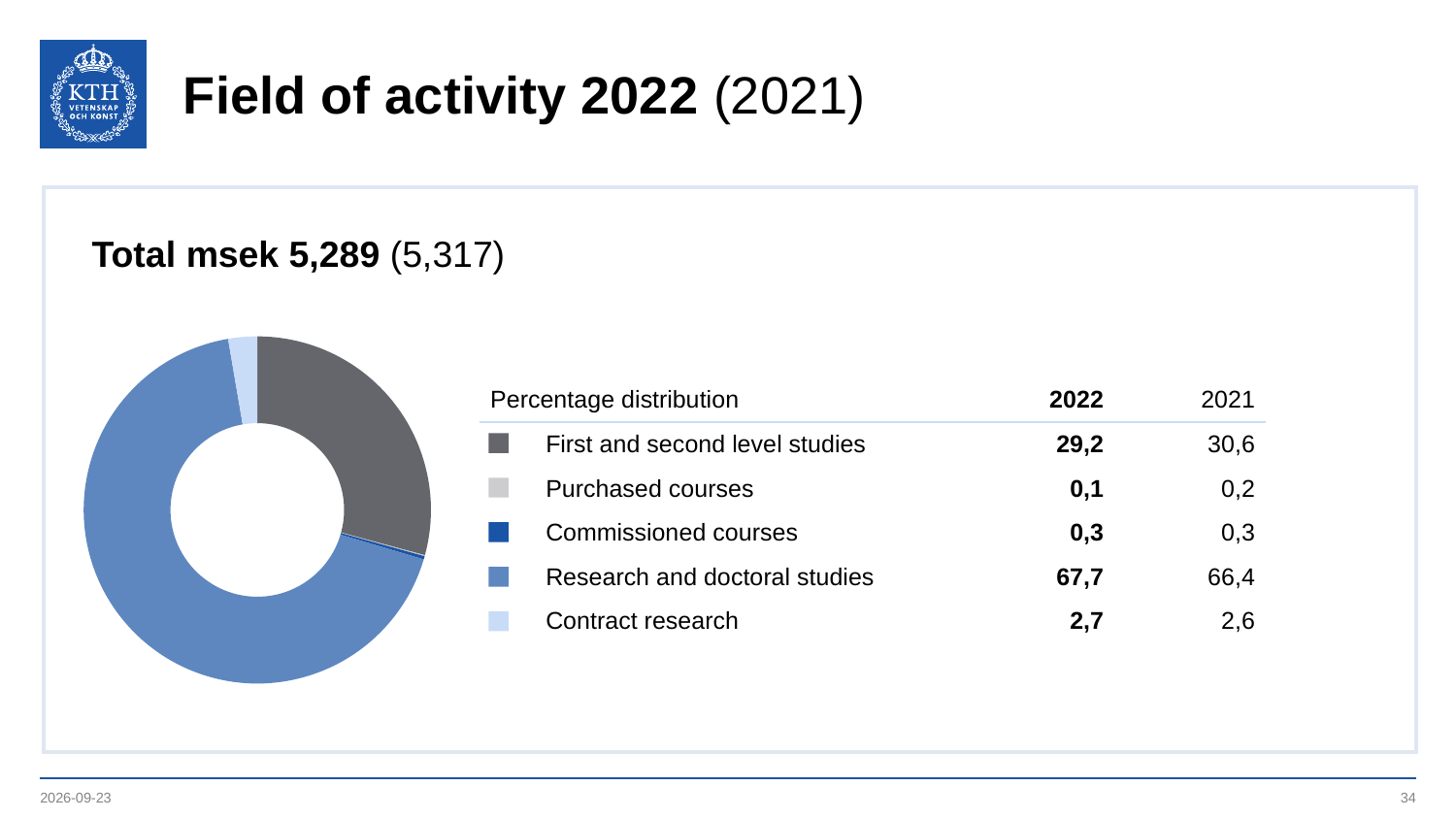
What is the 2022 percentage for Research and doctoral studies? 67,7 Which is larger in 2022: Contract research or Commissioned courses? Contract research How many categories are listed in the percentage distribution table? 5 Which category has the largest share in 2022? Research and doctoral studies Which category has the smallest share in 2022? Purchased courses What is the difference between the 2022 percentages for Research and doctoral studies and First and second level studies? 38,5 What kind of chart is shown on the slide? Donut (pie) chart What was the 2021 percentage for Contract research? 2,6 What is the 2022 percentage for First and second level studies? 29,2 What is the total in msek shown for 2022? 5,289 What colour represents Research and doctoral studies in the chart? Blue Did the share of First and second level studies rise or fall from 2021 to 2022? Fall